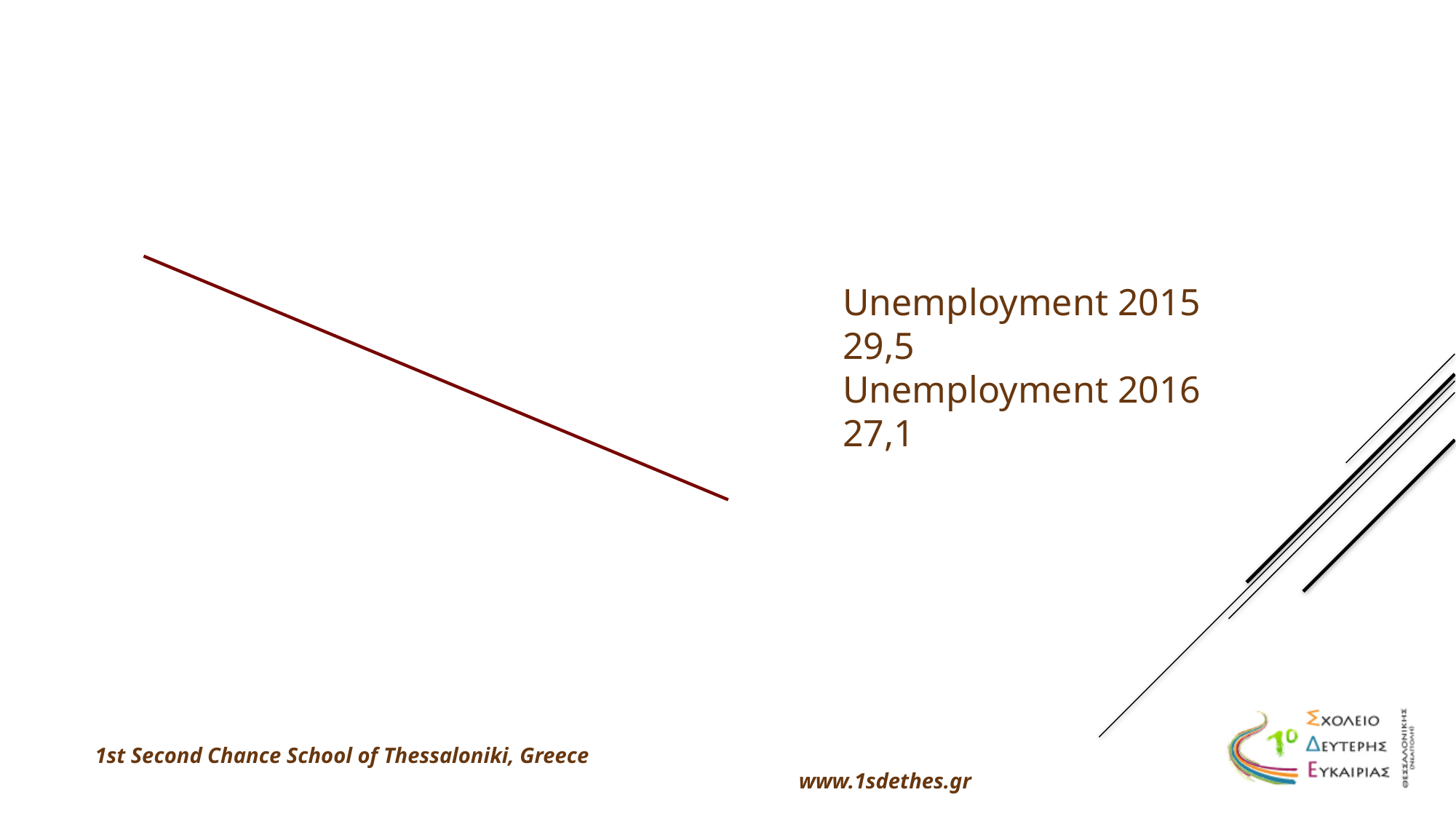
How many years of unemployment data are shown on the slide? 2 What is the difference between the unemployment values for 2015 and 2016? 2,4 Which year has the higher unemployment value, 2015 or 2016? 2015 What colour is the line plotted on the chart? dark red What is the unemployment value shown for 2016? 27,1 Which year has the lowest unemployment value shown? 2016 Which year has the highest unemployment value shown? 2015 What kind of chart is shown on the slide? line chart Does the line rise or fall from left to right? fall What is the unemployment value shown for 2015? 29,5